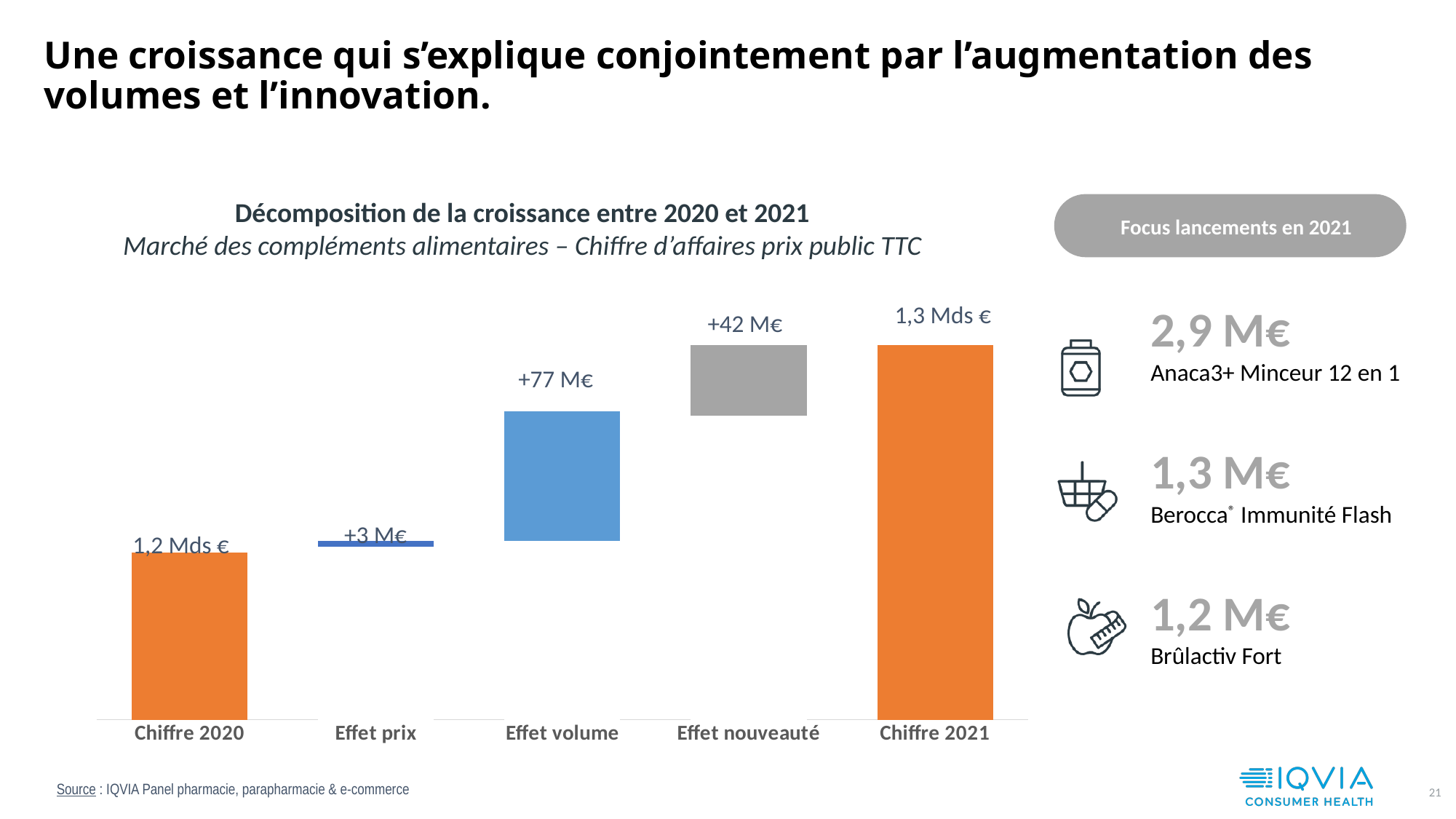
What is the difference between the Effet volume and the Effet nouveauté values? 35 M€ What kind of chart is shown on the slide? Bar chart (waterfall) Which of the three effects (Effet prix, Effet volume, Effet nouveauté) contributes the least to growth? Effet prix What is the value shown for Effet nouveauté? +42 M€ How many categories are shown on the x axis of the chart? 5 What is the value shown for Effet volume? +77 M€ Which is larger, the Effet nouveauté value or the Effet prix value? Effet nouveauté What is the value shown for Chiffre 2021? 1,3 Mds € Which of the three effects (Effet prix, Effet volume, Effet nouveauté) contributes the most to growth? Effet volume What is the value shown for Effet prix? +3 M€ What is the value shown for Chiffre 2020? 1,2 Mds € What is the title of the chart? Décomposition de la croissance entre 2020 et 2021